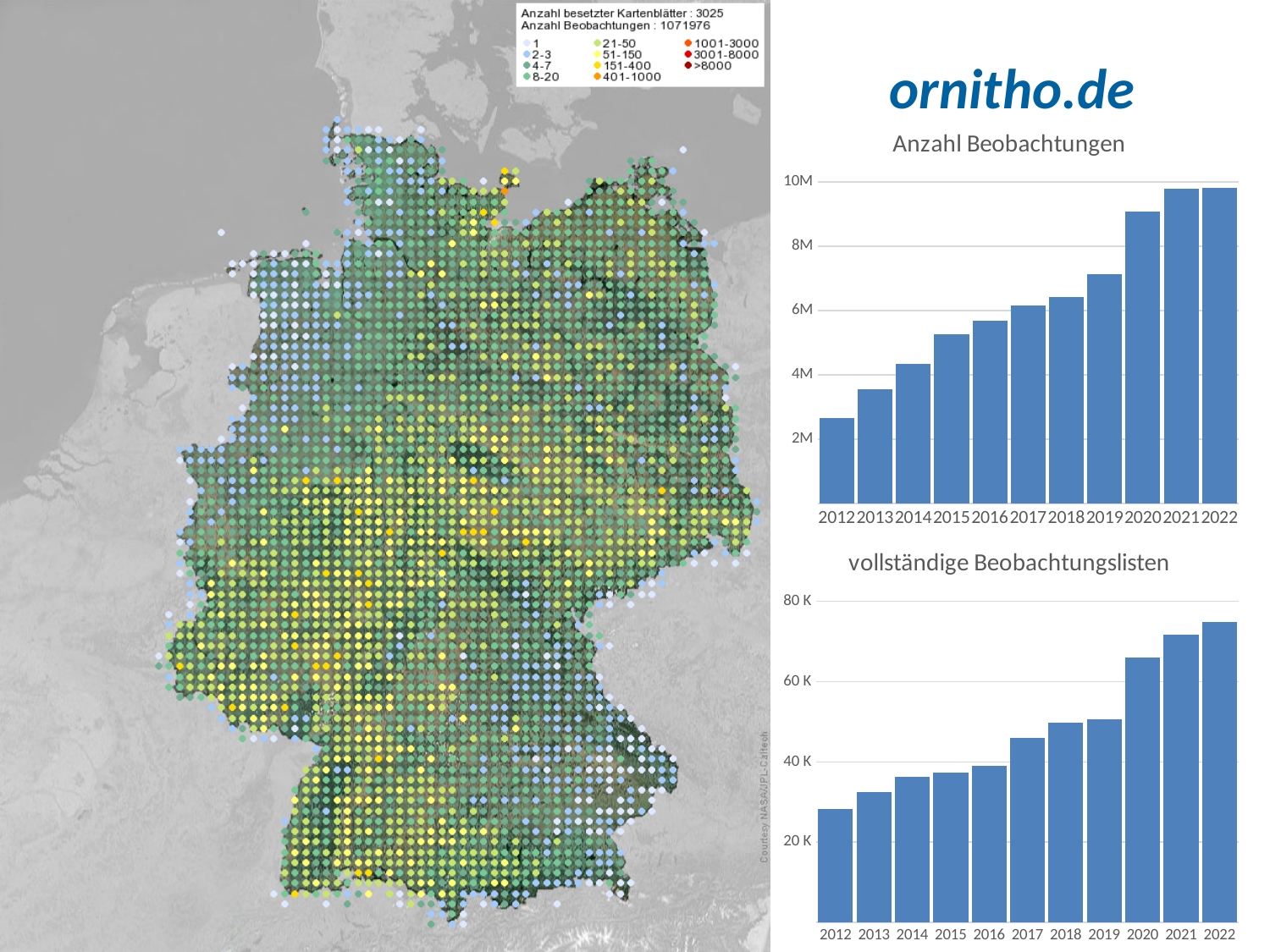
In the 'vollständige Beobachtungslisten' chart, is the value for 2012 greater or less than 40 K? less In the 'Anzahl Beobachtungen' chart, is the value for 2020 greater or less than 8M? greater In the 'vollständige Beobachtungslisten' chart, is the value for 2020 greater or less than 60 K? greater In the 'Anzahl Beobachtungen' chart, do the values generally rise or fall from 2012 to 2022? rise In the 'vollständige Beobachtungslisten' chart, which year has the highest value? 2022 In the 'Anzahl Beobachtungen' chart, how many years are shown on the x axis? 11 In the 'Anzahl Beobachtungen' chart, which is larger, the value for 2019 or the value for 2020? 2020 In the 'Anzahl Beobachtungen' chart, which year has the lowest value? 2012 In the 'vollständige Beobachtungslisten' chart, which year has the lowest value? 2012 What kind of chart is the 'Anzahl Beobachtungen' chart? bar chart